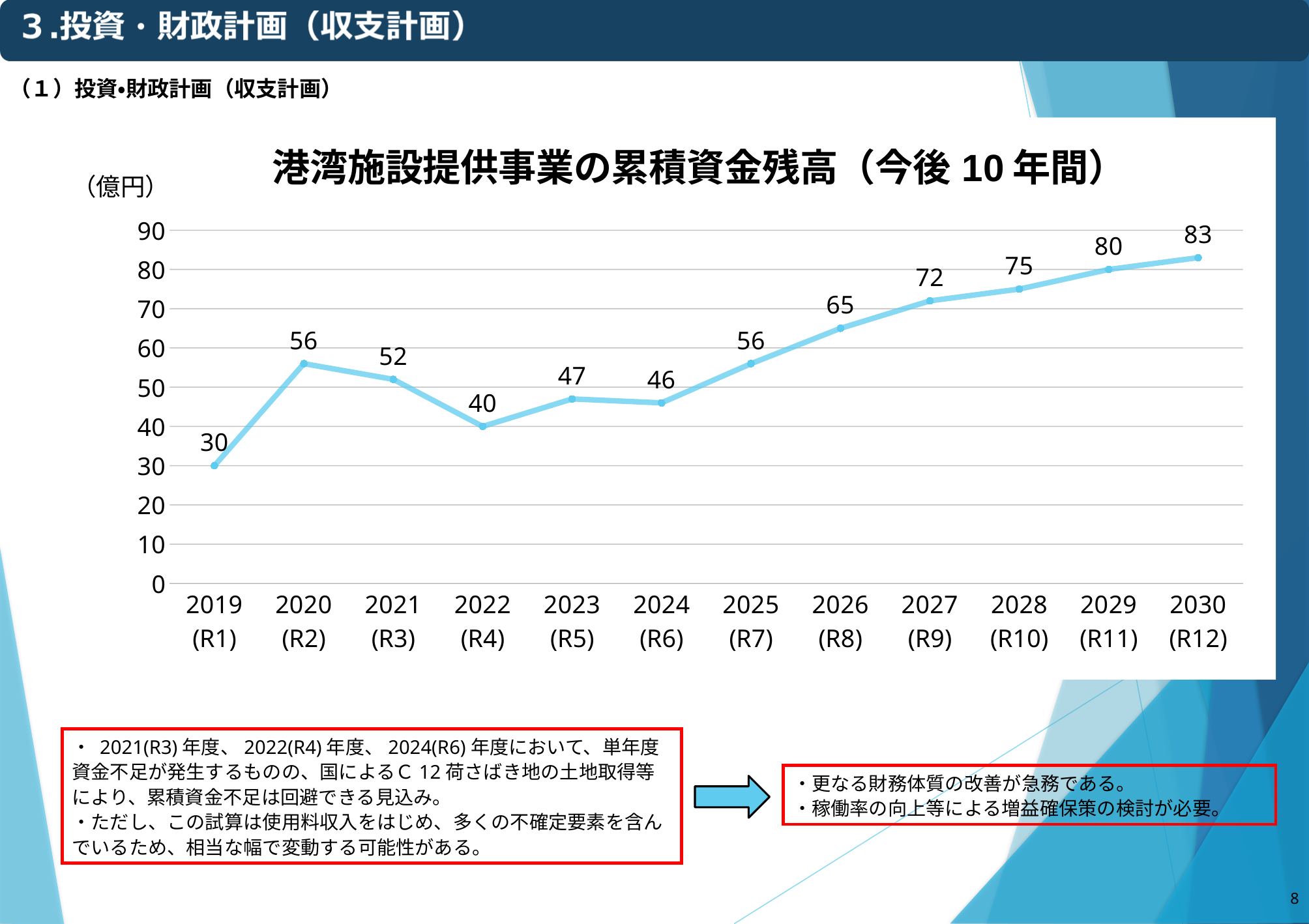
Which year has the highest value? 2030 (R12) What is the value for 2030 (R12)? 83 What unit is shown at the top left of the chart's vertical axis? 億円 What is the value for 2025 (R7)? 56 Do the values rise or fall from 2024 (R6) to 2030 (R12)? rise What kind of chart is this? line chart What is the value for 2019 (R1)? 30 What is the difference between the values for 2030 (R12) and 2019 (R1)? 53 Which is larger, the value for 2020 (R2) or the value for 2024 (R6)? 2020 (R2) Which year has the lowest value? 2019 (R1) How many years are plotted on the x axis? 12 What is the difference between the values for 2021 (R3) and 2022 (R4)? 12